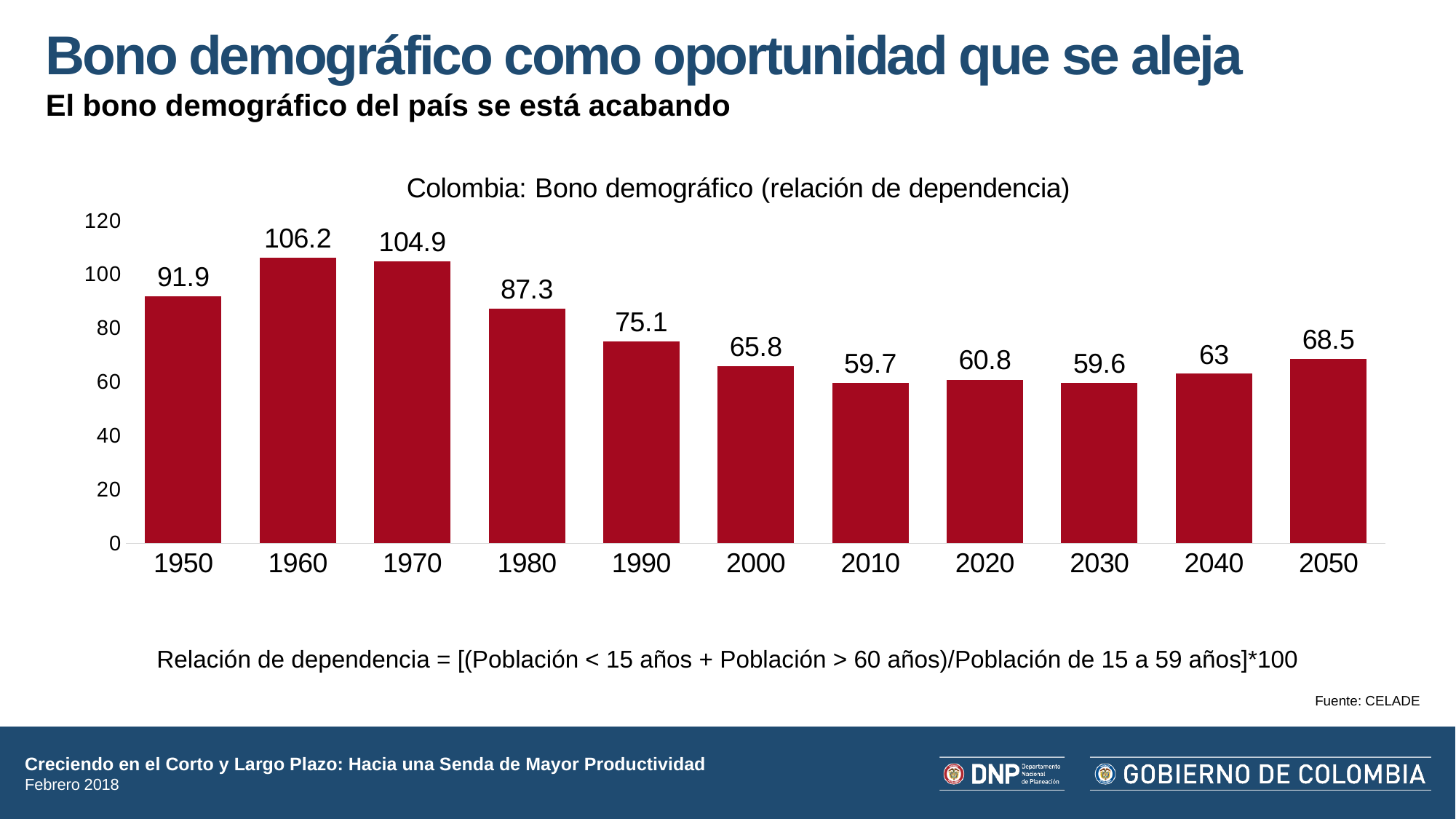
What kind of chart is shown on the slide? Bar chart What is the title of the chart? Colombia: Bono demográfico (relación de dependencia) What is the value shown for 1990? 75.1 How many years are shown on the x axis? 11 Which year has the lowest dependency ratio? 2030 Which is larger, the value for 2000 or the value for 2040? 2000 Which year has the highest dependency ratio? 1960 What is the difference between the values for 1950 and 1980? 4.6 What is the value shown for 2050? 68.5 What is the difference between the values for 1960 and 2030? 46.6 Is the value for 1970 greater or less than 100? greater What is the dependency ratio value for 1960? 106.2